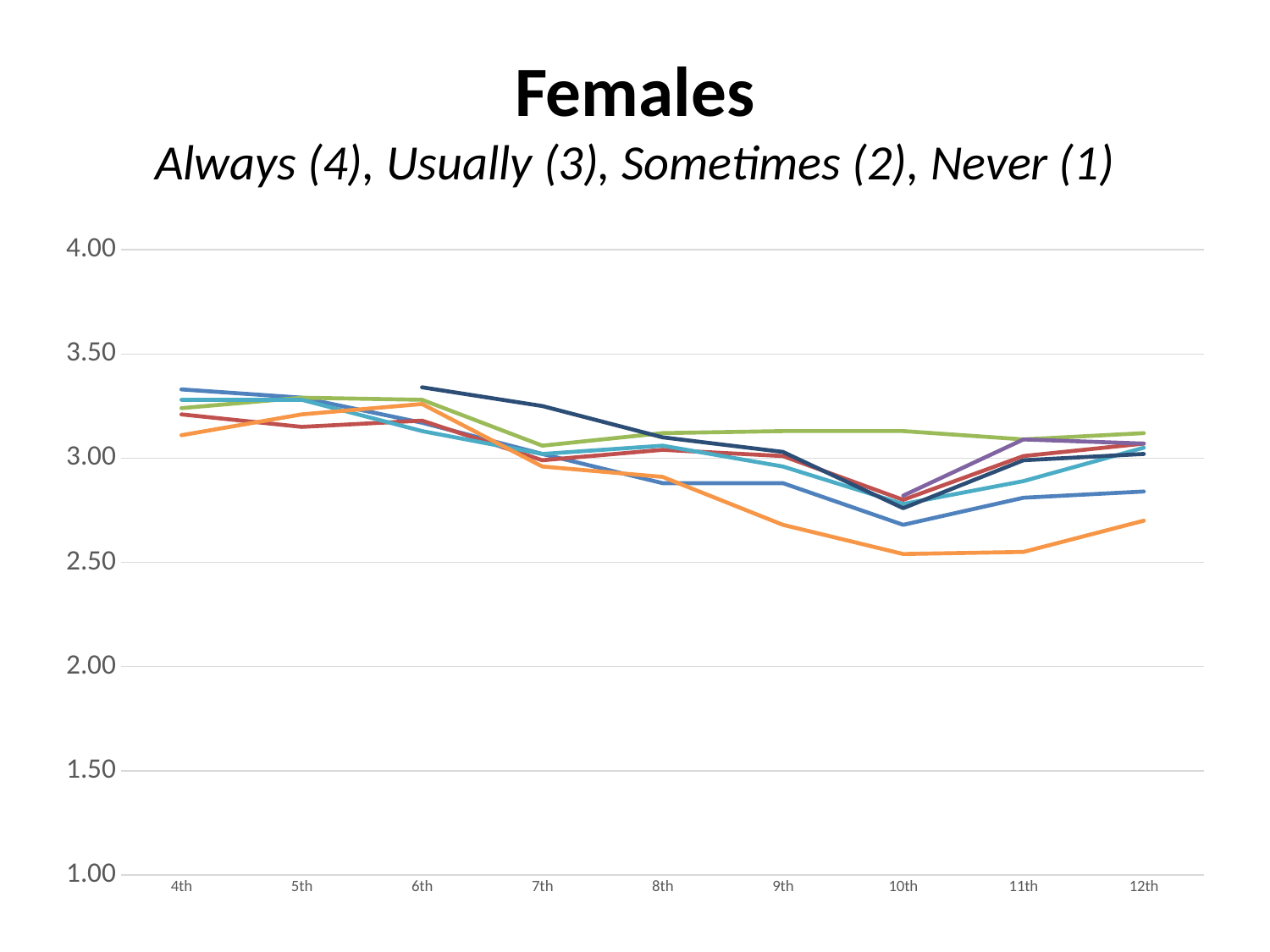
What is the highest value shown on the y axis? 4.00 Is the value of the green line at 10th greater or less than 3.00? greater Which line has the lowest value at 10th? the orange line Which line has the highest value at 10th? the green line Is the value of the green line at 12th greater or less than 3.00? greater At 12th, which is larger: the green line or the orange line? the green line Is the value of the orange line at 12th greater or less than 2.50? greater What kind of chart is shown on the slide? line chart What is the title of the chart? Females Do the lines generally rise or fall from 4th to 12th? fall How many grade categories are shown on the x axis? 9